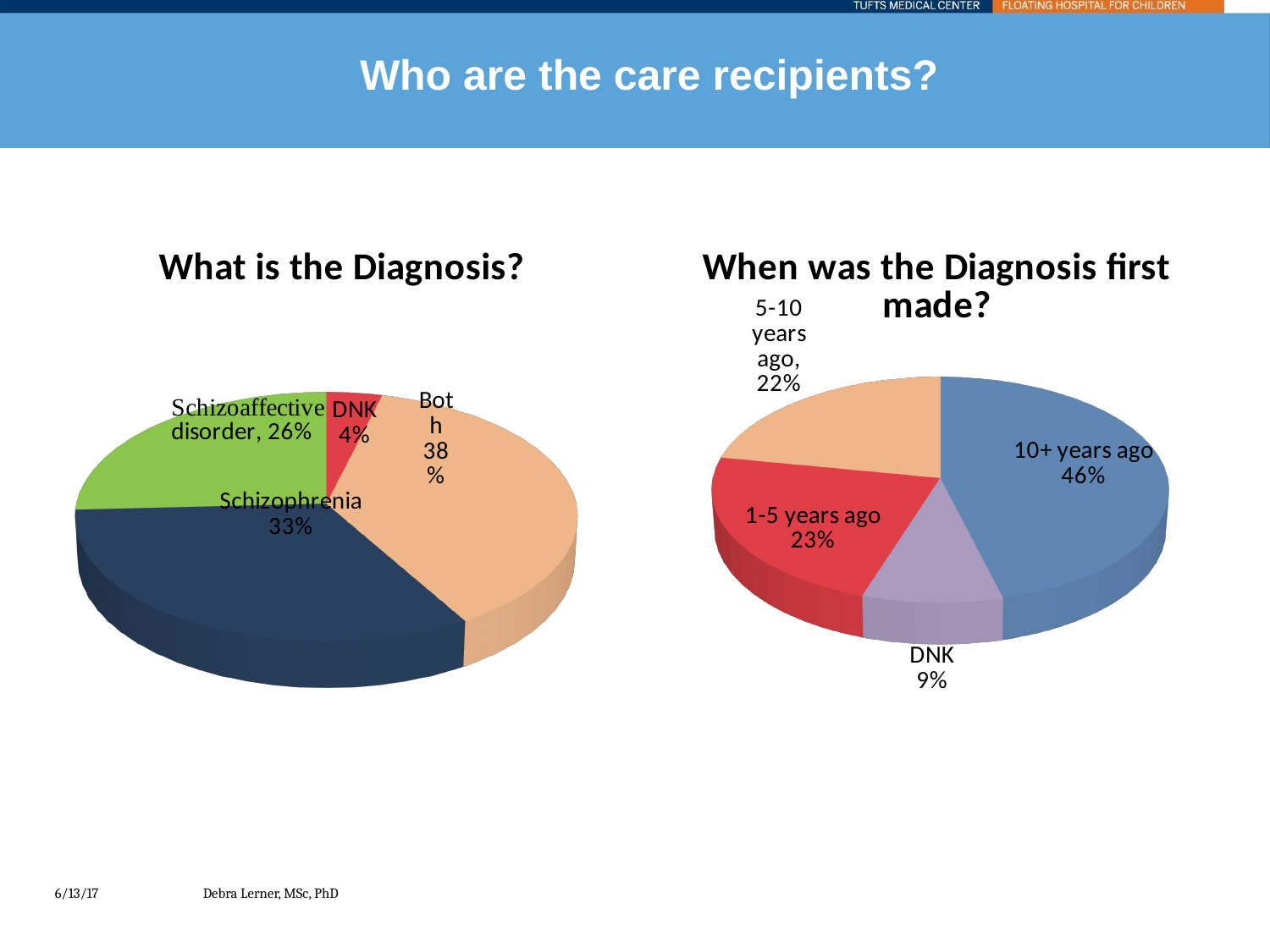
In the 'What is the Diagnosis?' chart, which category has the largest share? Both In the 'What is the Diagnosis?' chart, what share is Schizoaffective disorder? 26% In the 'When was the Diagnosis first made?' chart, what share is 10+ years ago? 46% In the 'What is the Diagnosis?' chart, how many slices are there? 4 In the 'What is the Diagnosis?' chart, which category has the smallest share? DNK In the 'When was the Diagnosis first made?' chart, what share is 1-5 years ago? 23% In the 'When was the Diagnosis first made?' chart, which is larger: 1-5 years ago or 5-10 years ago? 1-5 years ago In the 'What is the Diagnosis?' chart, what share is Schizophrenia? 33% In the 'What is the Diagnosis?' chart, what is the difference between the Both and Schizophrenia shares? 5% What kind of chart is the 'When was the Diagnosis first made?' chart? Pie chart In the 'What is the Diagnosis?' chart, what share is Both? 38% In the 'When was the Diagnosis first made?' chart, which category has the smallest share? DNK